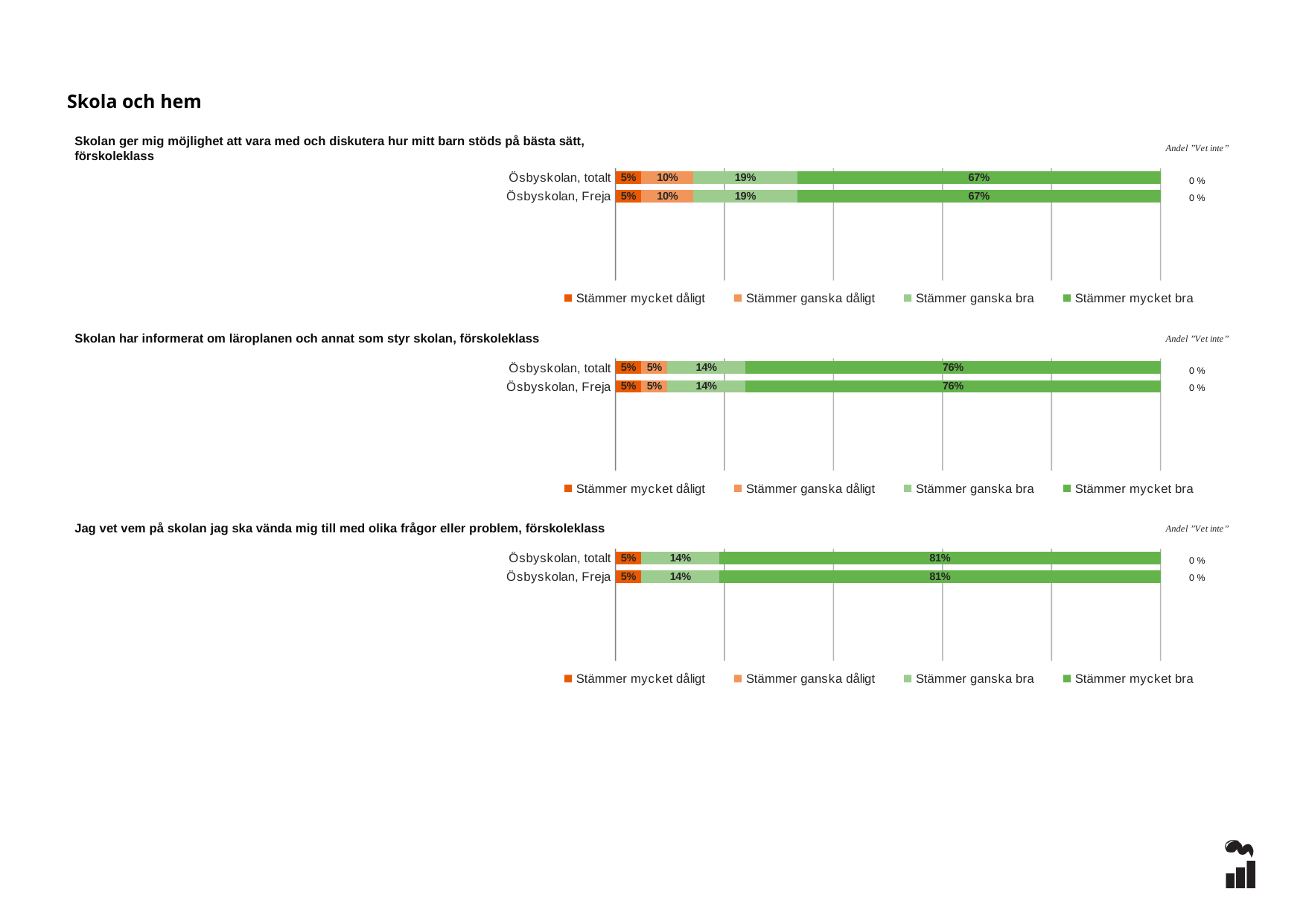
In the chart titled "Skolan ger mig möjlighet att vara med och diskutera hur mitt barn stöds på bästa sätt, förskoleklass", what is the value of "Stämmer mycket bra" for Ösbyskolan, totalt? 67% In the top chart, what is the value of "Stämmer ganska bra" for Ösbyskolan, totalt? 19% What kind of chart is the top chart? Stacked bar chart In the top chart, what is the difference between "Stämmer mycket bra" and "Stämmer ganska bra" for Ösbyskolan, totalt? 48% In the top chart, what is the value of "Stämmer ganska dåligt" for Ösbyskolan, Freja? 10% How many series does the legend of the middle chart list? 4 In the middle chart, what is the value of "Stämmer ganska bra" for Ösbyskolan, totalt? 14% In the chart titled "Jag vet vem på skolan jag ska vända mig till med olika frågor eller problem, förskoleklass", what is the value of "Stämmer mycket bra" for Ösbyskolan, totalt? 81% In the bottom chart, which is larger for Ösbyskolan, totalt: "Stämmer ganska bra" or "Stämmer mycket dåligt"? Stämmer ganska bra In the chart titled "Skolan har informerat om läroplanen och annat som styr skolan, förskoleklass", what is the value of "Stämmer mycket bra" for Ösbyskolan, Freja? 76% In the middle chart, which response category has the highest value for Ösbyskolan, totalt? Stämmer mycket bra In the bottom chart, what is the value of "Stämmer mycket dåligt" for Ösbyskolan, Freja? 5%